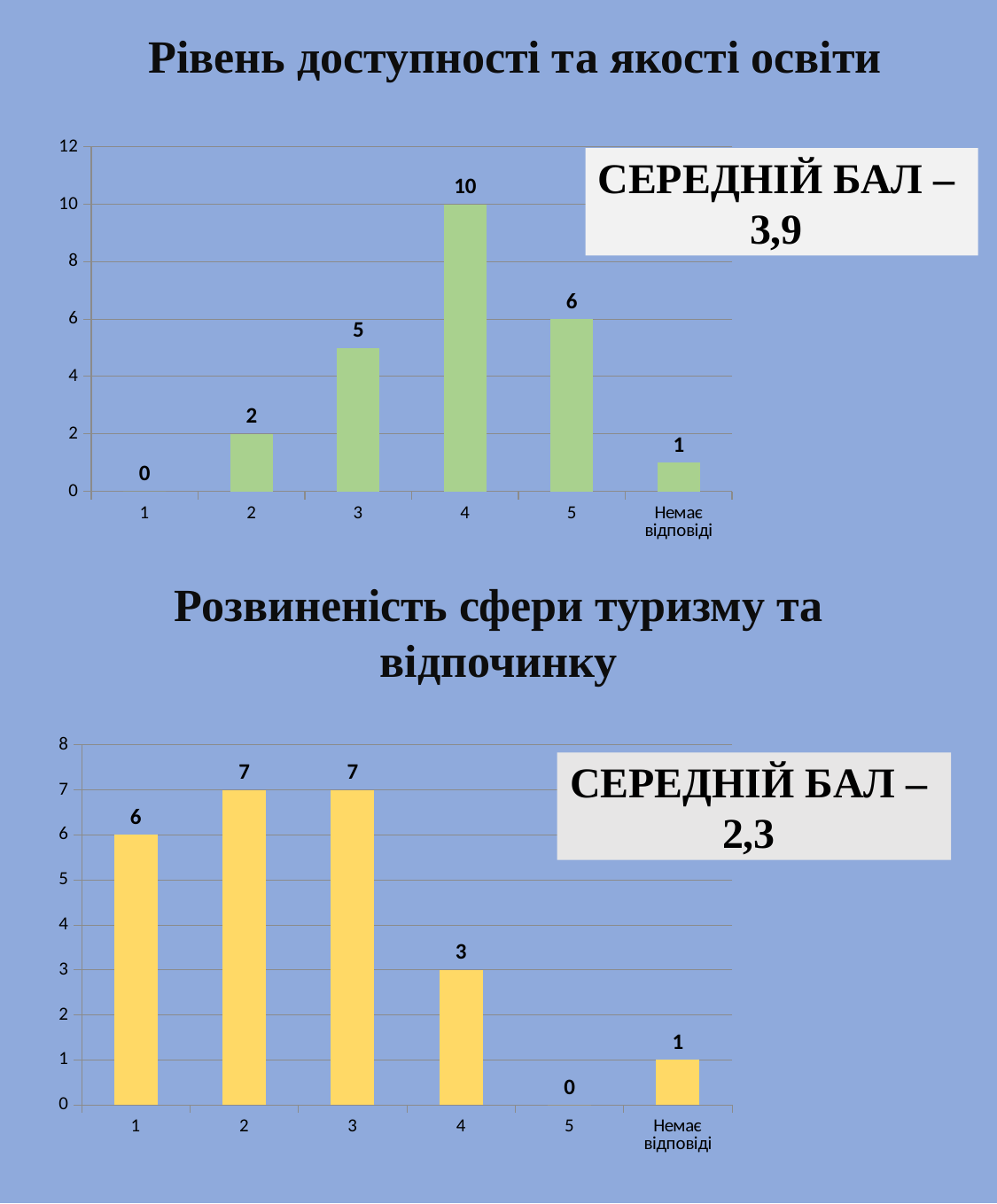
In the top chart 'Рівень доступності та якості освіти', what is the difference between the values for category 4 and category 5? 4 What kind of chart is the bottom chart 'Розвиненість сфери туризму та відпочинку'? bar chart In the bottom chart 'Розвиненість сфери туризму та відпочинку', what is the difference between the values for category 2 and category 4? 4 In the bottom chart 'Розвиненість сфери туризму та відпочинку', what is the value for category 1? 6 In the top chart 'Рівень доступності та якості освіти', which category has the highest value? 4 What average score (СЕРЕДНІЙ БАЛ) is shown for the bottom chart 'Розвиненість сфери туризму та відпочинку'? 2,3 In the top chart 'Рівень доступності та якості освіти', how many categories are shown on the x axis? 6 In the bottom chart 'Розвиненість сфери туризму та відпочинку', which category has the lowest value? 5 In the top chart 'Рівень доступності та якості освіти', what is the value for category 4? 10 What average score (СЕРЕДНІЙ БАЛ) is shown for the top chart 'Рівень доступності та якості освіти'? 3,9 In the top chart 'Рівень доступності та якості освіти', what is the value for 'Немає відповіді'? 1 In the bottom chart 'Розвиненість сфери туризму та відпочинку', which is larger, the value for category 3 or category 4? category 3